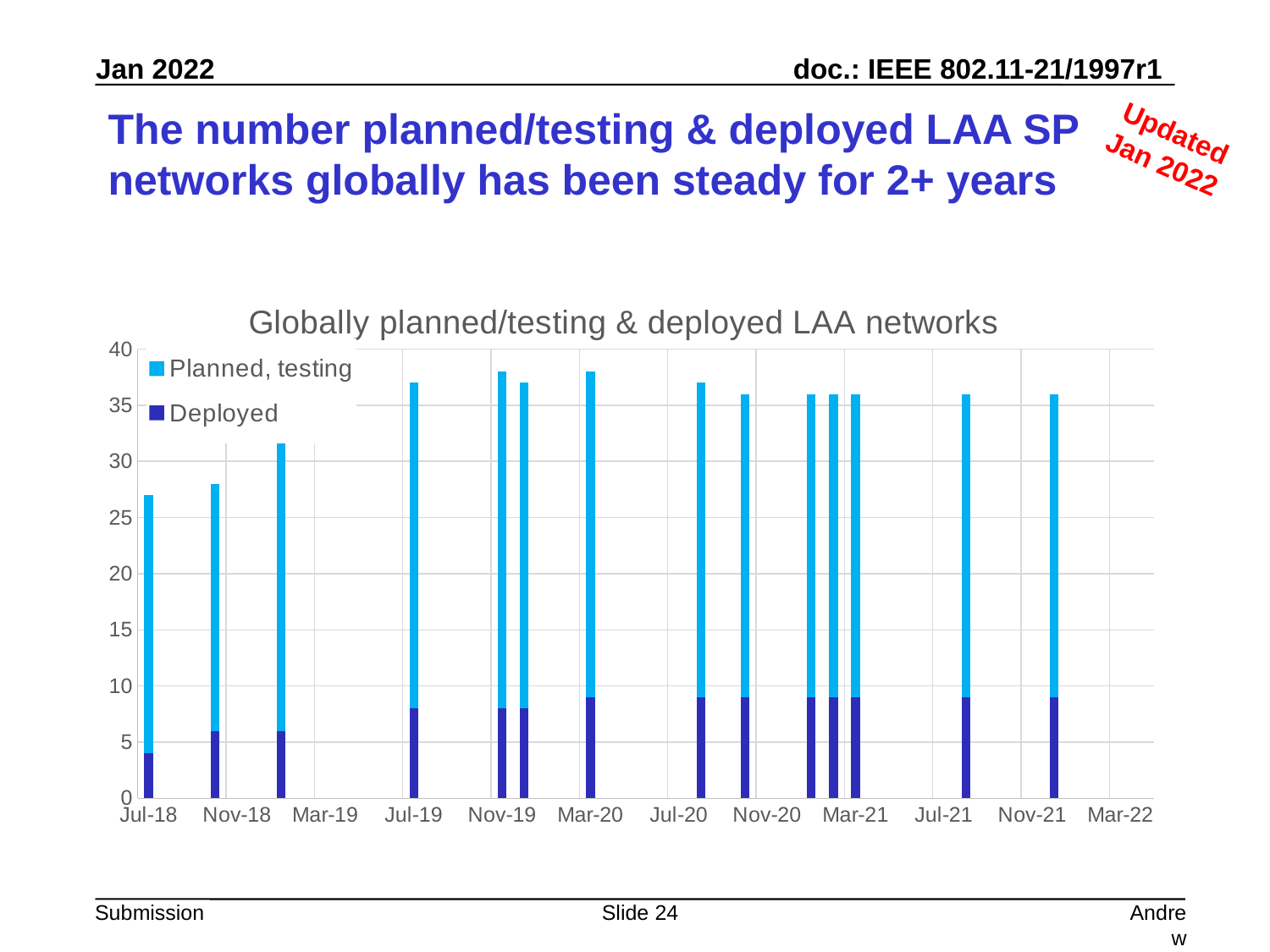
Is the Deployed value for the bar at Mar-20 greater or less than 10? less Do the total bar heights rise or fall from Jul-18 to Jul-19? rise Is the Deployed value for the bar at Jul-18 greater or less than 5? less What is the title of the chart? Globally planned/testing & deployed LAA networks Which series is shown in dark blue in the legend? Deployed Is the total height of the bar at Jul-18 greater or less than 30? less Which bar has the lowest total height in the chart? Jul-18 Which bar has the lowest total height, the one at Jul-18 or the one at Jul-19? Jul-18 What kind of chart is shown on the slide? Stacked bar chart How many series does the legend list? 2